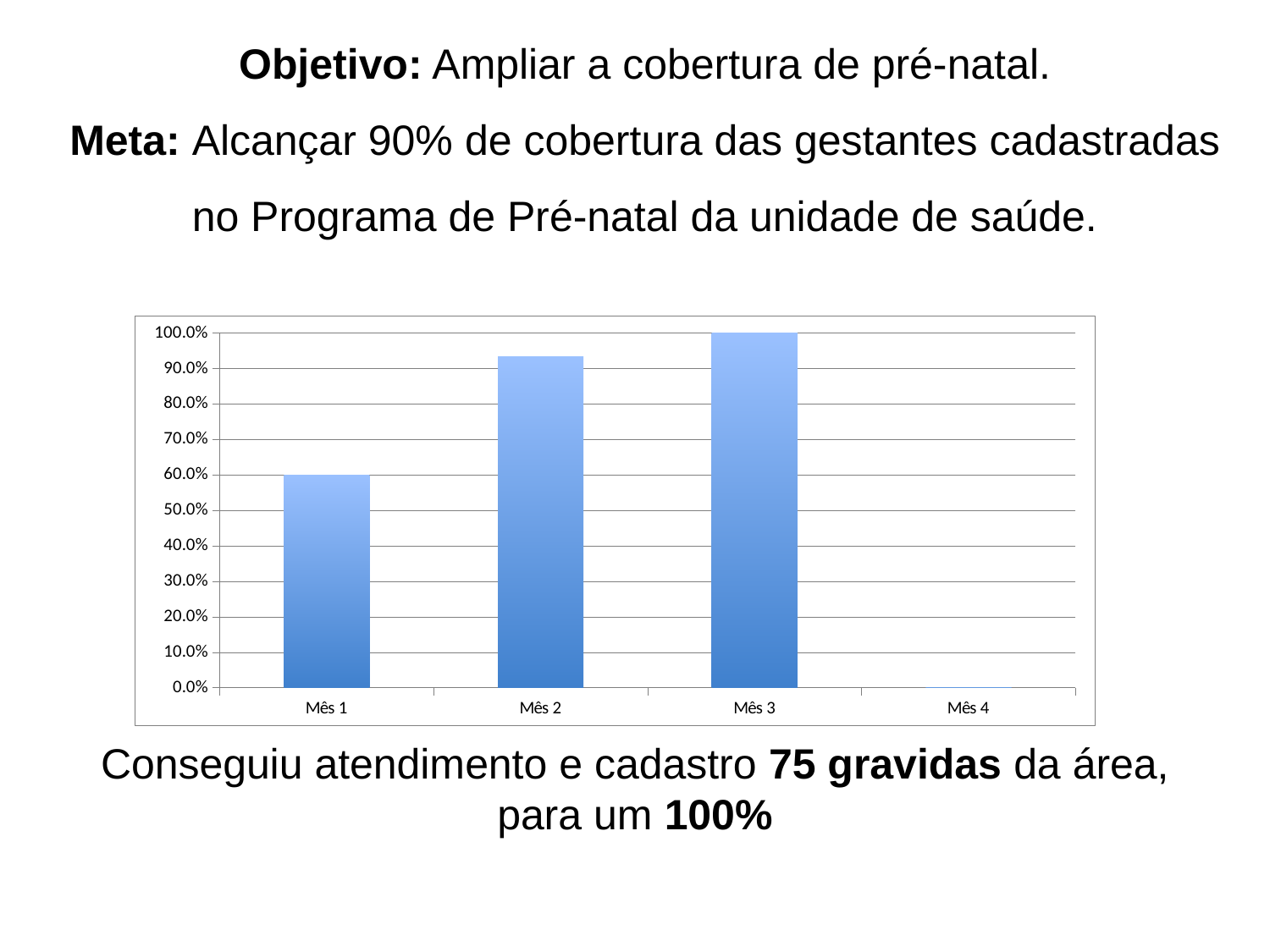
What type of chart is shown on the slide? Bar chart How many months (categories) are shown on the x axis of the chart? 4 Is the value for Mês 2 greater or less than 90.0%? greater Is the value for Mês 2 greater or less than 100.0%? less Which month has the highest value in the chart? Mês 3 What is the value for Mês 1 in the chart? 60.0% Do the values rise or fall from Mês 1 to Mês 3? Rise What is the value for Mês 3 in the chart? 100.0% What is the difference between the values for Mês 3 and Mês 1? 40.0% Among Mês 1, Mês 2 and Mês 3, which month has the lowest value? Mês 1 Which is larger, the value for Mês 1 or the value for Mês 2? Mês 2 What is the highest value shown on the chart's y axis? 100.0%